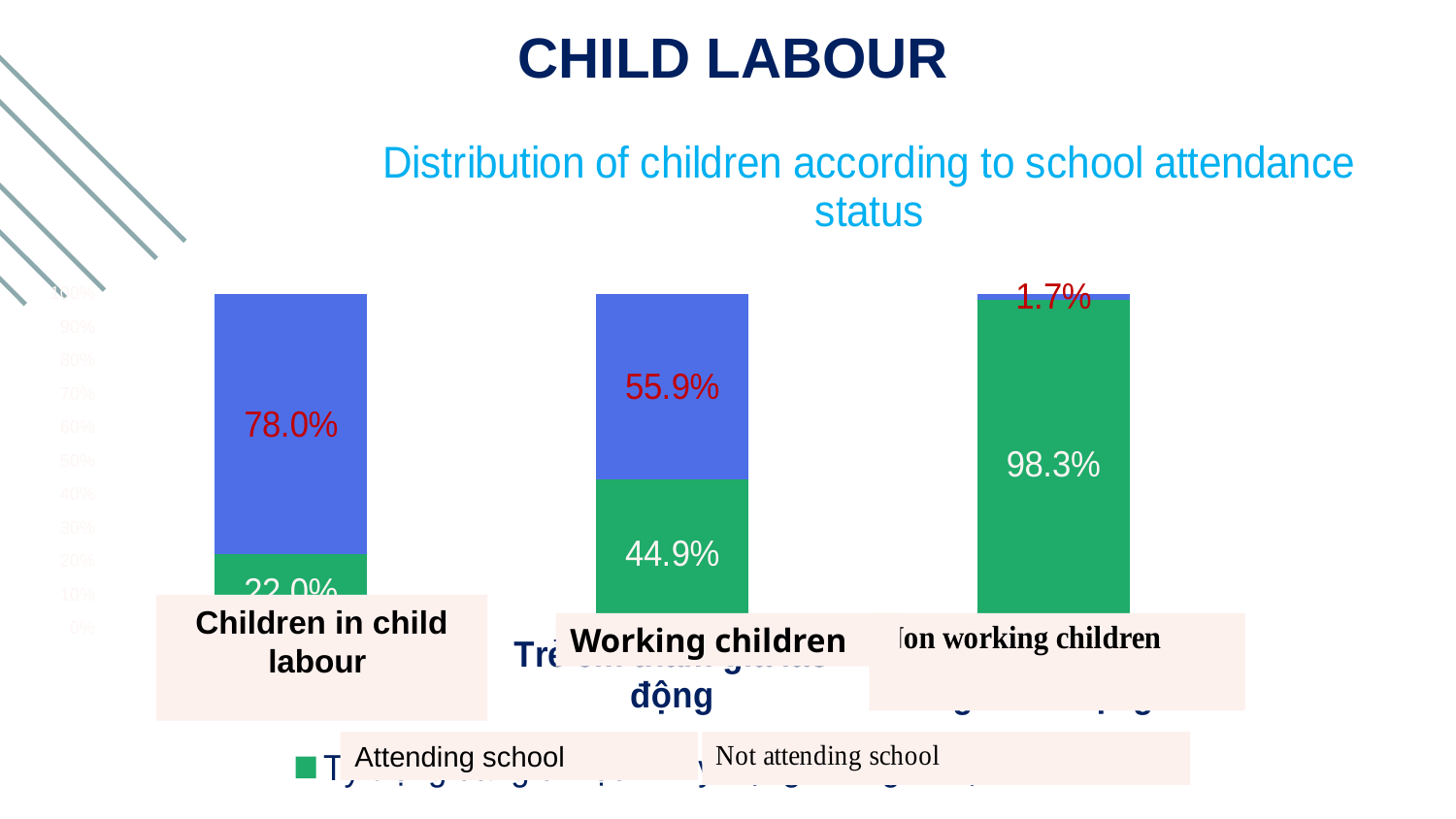
What kind of chart is shown on the slide? Stacked bar chart What percentage of non working children are attending school? 98.3% For working children, what is the difference between the share not attending school and the share attending school? 11.0 percentage points Which category has the highest share of children attending school? Non working children Which category has the lowest share of children not attending school? Non working children How many categories are shown on the x axis of the chart? 3 What percentage of non working children are not attending school? 1.7% What percentage of working children are attending school? 44.9% Which has a larger share of children not attending school: children in child labour or working children? Children in child labour How many series does the chart's legend list? 2 What percentage of children in child labour are not attending school? 78.0% What percentage of working children are not attending school? 55.9%